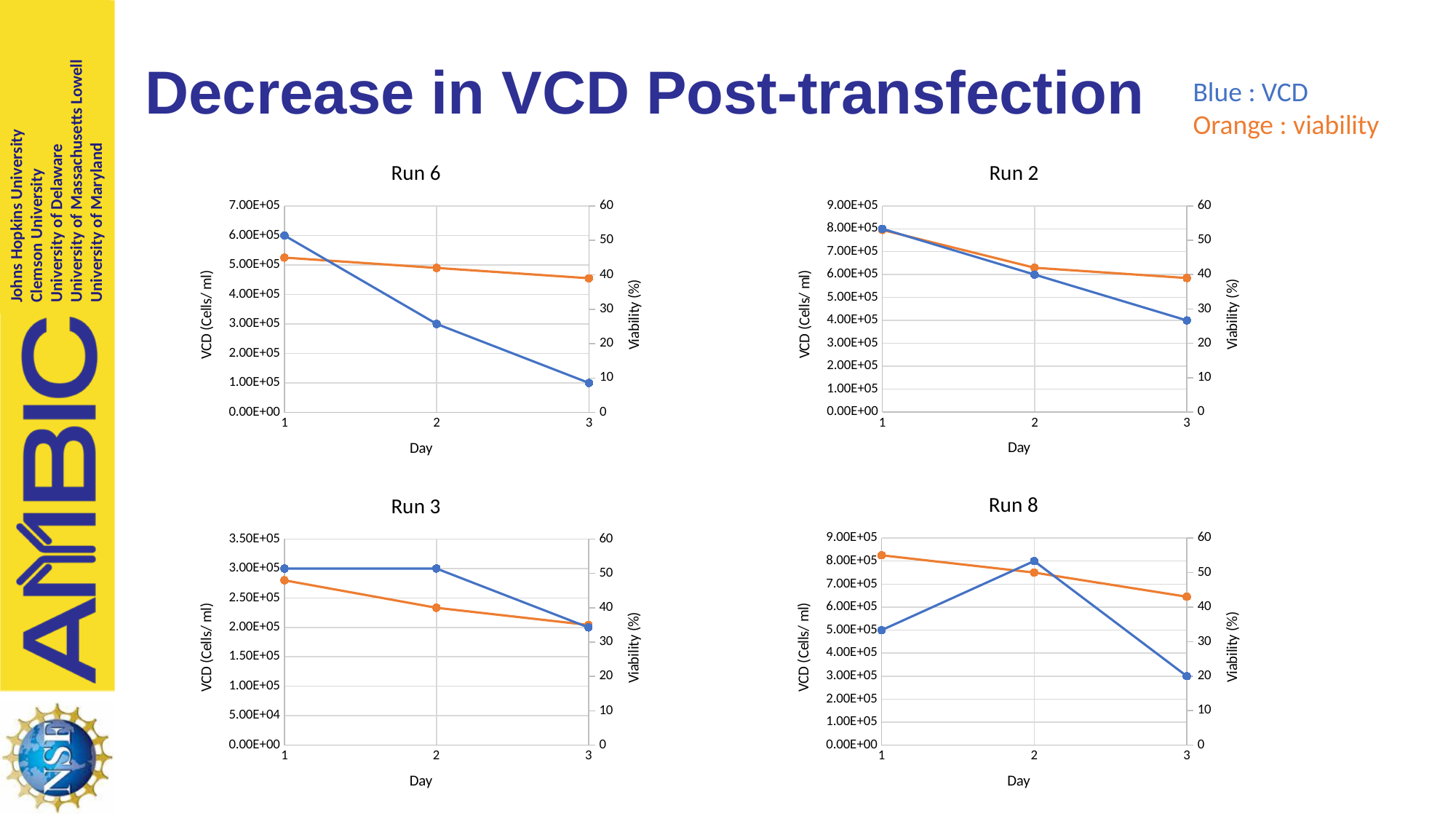
In the Run 8 chart, what is the VCD value on day 2? 8.00E+05 In the Run 3 chart, is the viability on day 1 greater or less than 40? greater How many days are plotted on the x axis of the Run 6 chart? 3 In the Run 2 chart, what is the VCD value on day 1? 8.00E+05 In the Run 8 chart, on which day is the VCD highest? 2 What kind of chart is the Run 6 chart? line chart In the Run 8 chart, is the viability on day 3 greater or less than 50? less In the Run 3 chart, what is the VCD value on day 3? 2.00E+05 In the Run 6 chart, what is the VCD value on day 3? 1.00E+05 In the Run 6 chart, does the VCD rise or fall from day 1 to day 3? fall According to the slide's key, which quantity does the orange line represent? viability